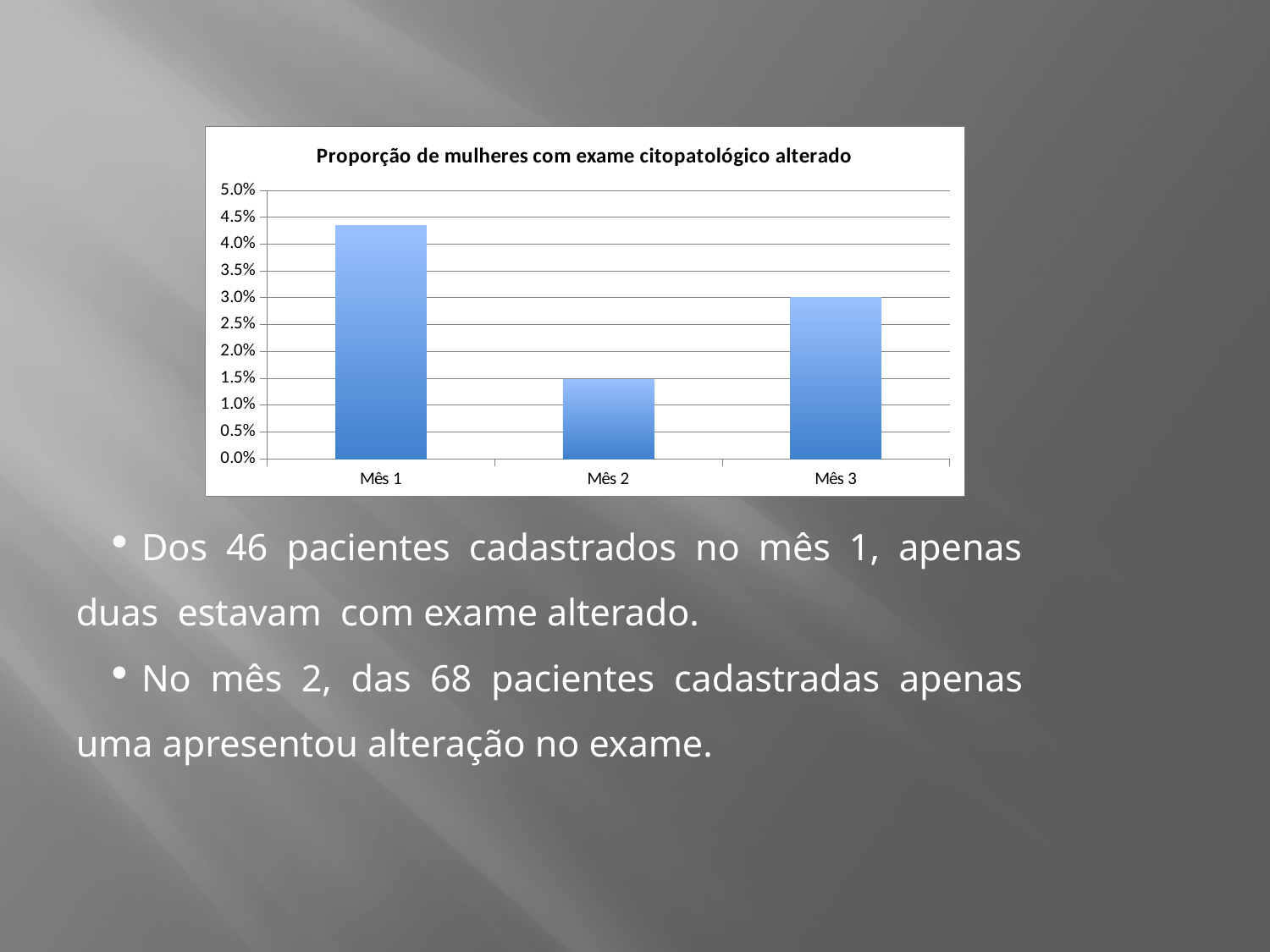
Which month has the lowest proportion of women with altered cytopathological exam? Mês 2 How many categories (months) are shown on the x axis of the chart? 3 What kind of chart is shown on the slide? bar chart What is the value for Mês 3 in the chart? 3.0% Is the value for Mês 2 greater or less than 2.0%? less Which is larger, the value for Mês 1 or the value for Mês 3? Mês 1 What is the title of the chart? Proporção de mulheres com exame citopatológico alterado Which month has the highest proportion of women with altered cytopathological exam? Mês 1 What is the maximum value shown on the y axis of the chart? 5.0% Is the value for Mês 1 greater or less than 4.0%? greater Is the value for Mês 3 greater or less than 2.0%? greater Which is larger, the value for Mês 2 or the value for Mês 3? Mês 3